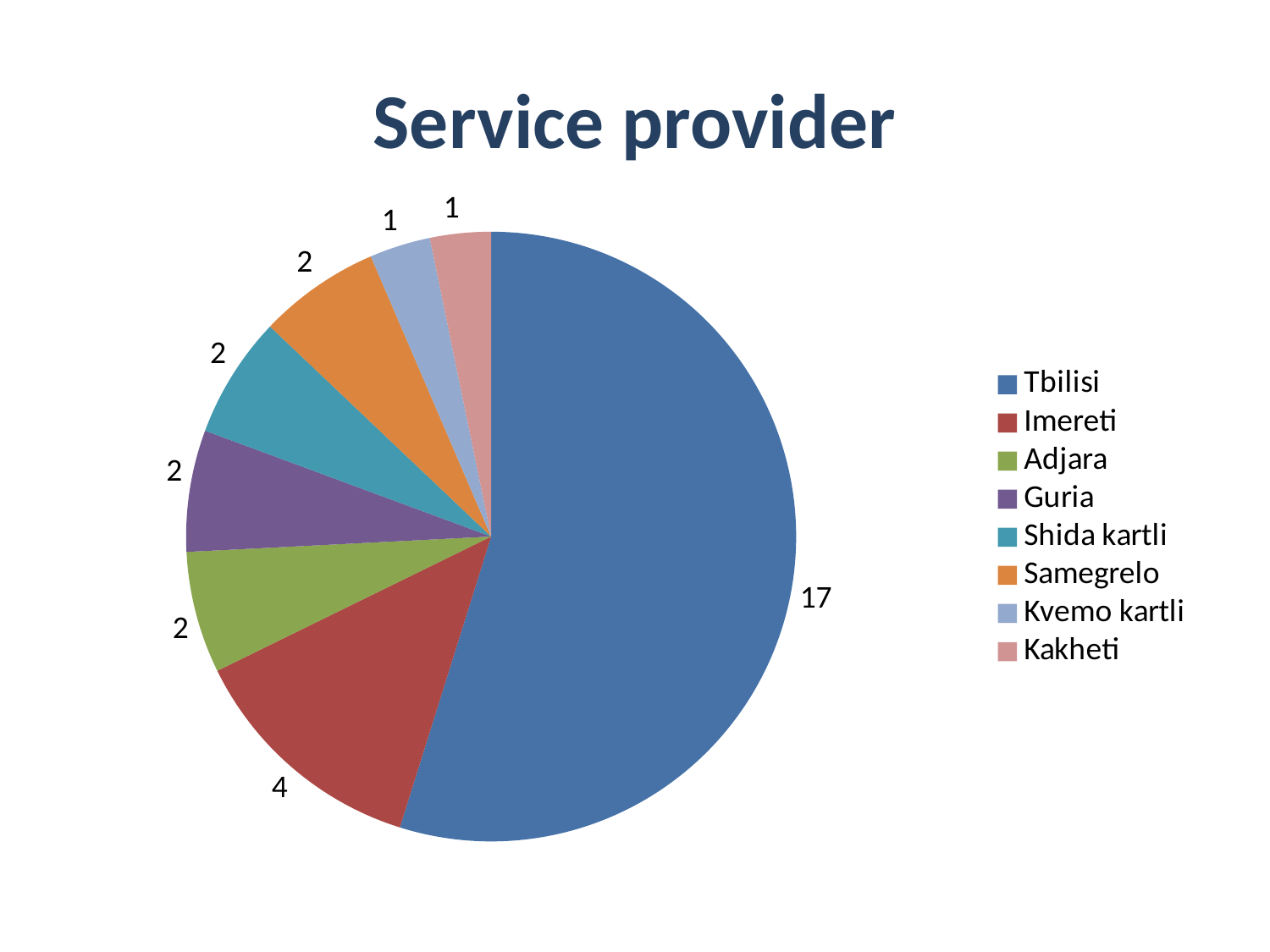
What is the value for Kakheti? 1 What type of chart is shown on the slide? pie chart Which is larger, the value for Imereti or the value for Adjara? Imereti Which colour represents Tbilisi in the legend? blue What is the value for Tbilisi? 17 How many categories does the legend list? 8 What is the title of the chart? Service provider What is the total of all the slices in the pie? 31 What is the value for Samegrelo? 2 Which category has the largest slice of the pie? Tbilisi What is the difference between the values for Tbilisi and Imereti? 13 What is the value for Imereti? 4